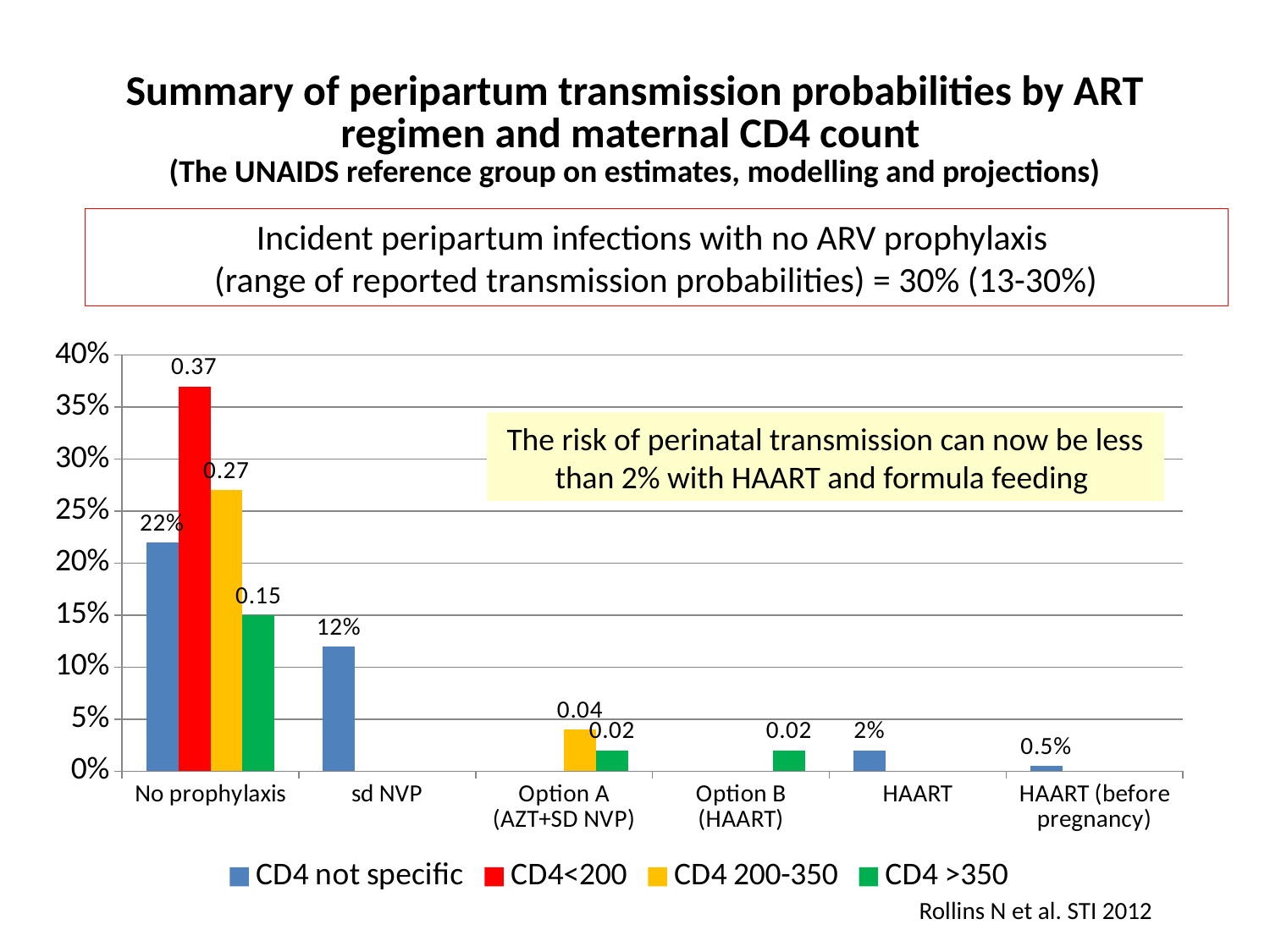
Which series has the lowest value under No prophylaxis? CD4 >350 What is the value for CD4 not specific under sd NVP? 12% Which series has the highest value under No prophylaxis? CD4<200 What is the value for CD4 >350 under Option B (HAART)? 0.02 How many series does the legend list? 4 Is the value for CD4 not specific under No prophylaxis greater or less than 20%? greater What is the value for CD4 200-350 under Option A (AZT+SD NVP)? 0.04 Which is larger under No prophylaxis: the CD4 200-350 bar or the CD4 >350 bar? CD4 200-350 What kind of chart is shown on the slide? Bar chart How many categories are shown on the x axis? 6 What is the value for CD4<200 under No prophylaxis? 0.37 What is the value for CD4 not specific under HAART (before pregnancy)? 0.5%